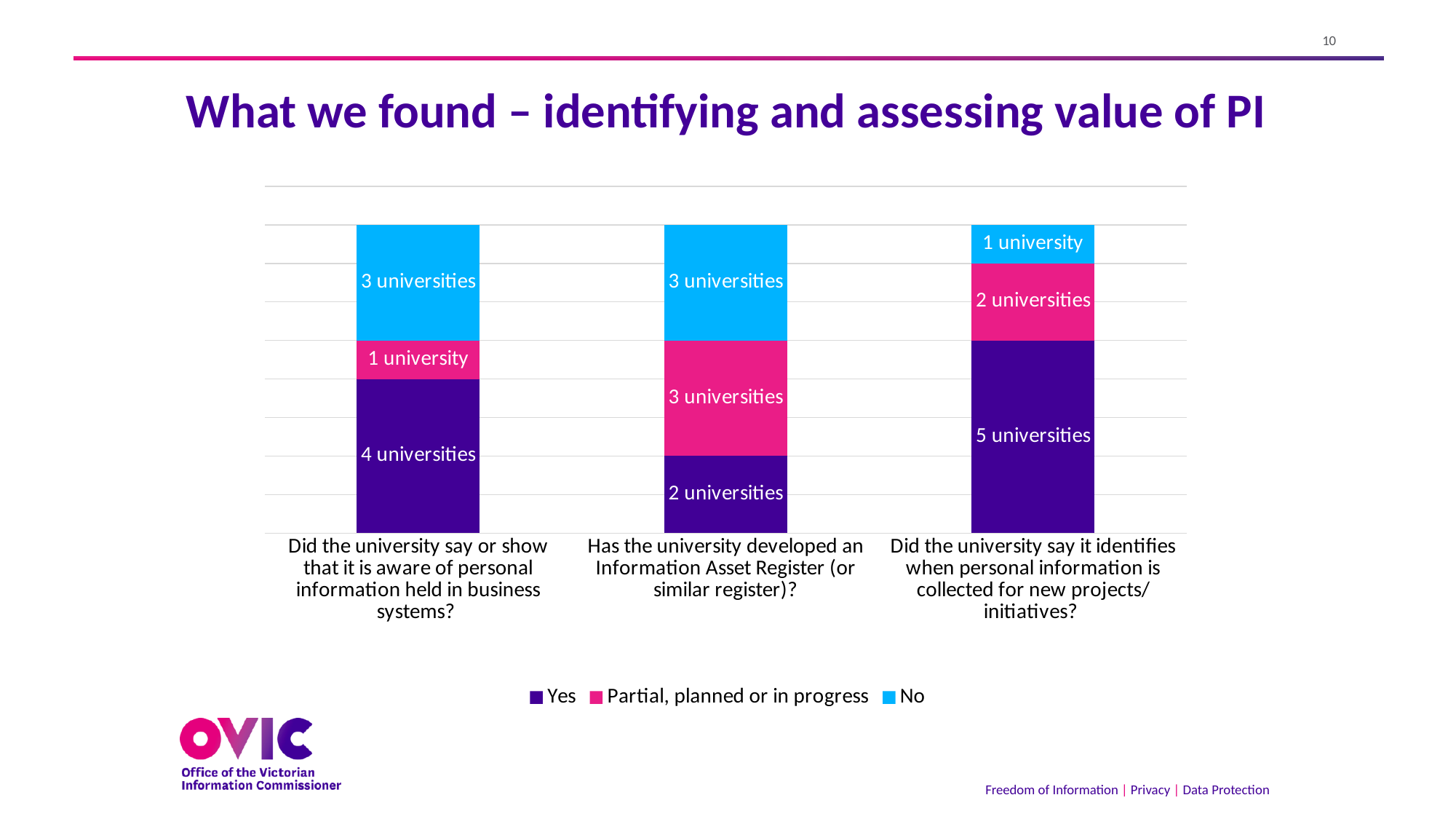
What is the difference between the 'Yes' value and the 'No' value for 'Did the university say it identifies when personal information is collected for new projects/ initiatives?' 4 universities What is the 'Partial, planned or in progress' value for 'Did the university say it identifies when personal information is collected for new projects/ initiatives?' 2 universities What is the 'Yes' value for 'Did the university say or show that it is aware of personal information held in business systems?' 4 universities Which colour represents the 'No' series in the chart? Light blue How many categories (questions) are shown on the x axis? 3 What is the total number of universities in the stacked bar for 'Has the university developed an Information Asset Register (or similar register)?' 8 universities Which is larger for 'Has the university developed an Information Asset Register (or similar register)?': the 'Yes' value or the 'Partial, planned or in progress' value? Partial, planned or in progress What kind of chart is shown on the slide? Stacked bar chart Which question has the highest 'Yes' value? Did the university say it identifies when personal information is collected for new projects/ initiatives? How many series does the legend list? 3 What is the 'No' value for 'Has the university developed an Information Asset Register (or similar register)?' 3 universities Which question has the lowest 'Yes' value? Has the university developed an Information Asset Register (or similar register)?